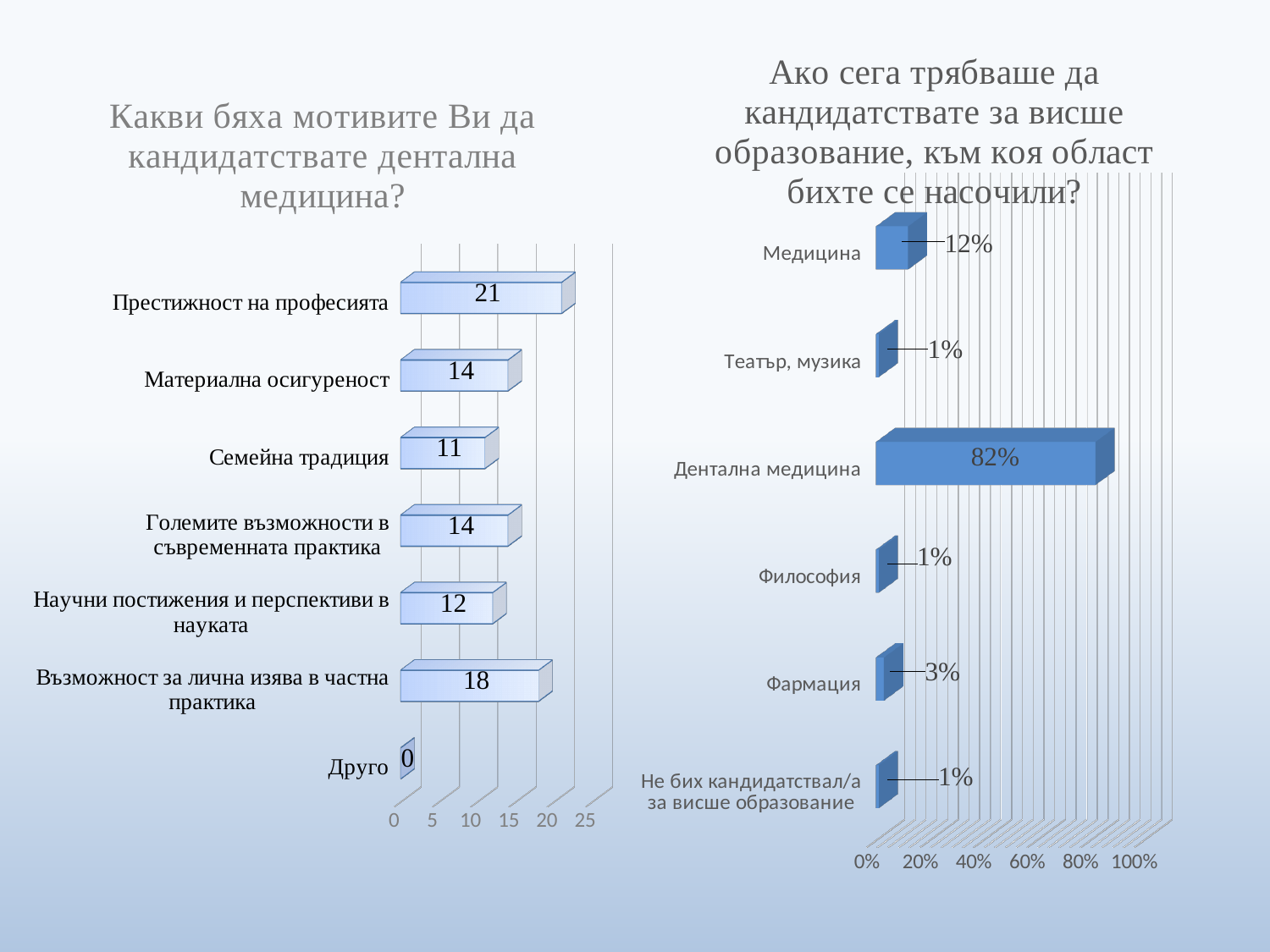
What type of chart is the right chart (Ако сега трябваше да кандидатствате за висше образование...)? Bar chart In the left chart (Какви бяха мотивите Ви да кандидатствате дентална медицина?), which category has the lowest value? Друго In the left chart (Какви бяха мотивите Ви да кандидатствате дентална медицина?), which is larger: Научни постижения и перспективи в науката or Възможност за лична изява в частна практика? Възможност за лична изява в частна практика In the right chart (Ако сега трябваше да кандидатствате за висше образование...), what is the value for Фармация? 3% In the right chart (Ако сега трябваше да кандидатствате за висше образование...), what is the value for Дентална медицина? 82% In the left chart (Какви бяха мотивите Ви да кандидатствате дентална медицина?), what is the difference between Престижност на професията and Семейна традиция? 10 In the right chart (Ако сега трябваше да кандидатствате за висше образование...), what is the difference between Дентална медицина and Медицина? 70% In the left chart (Какви бяха мотивите Ви да кандидатствате дентална медицина?), what is the value for Престижност на професията? 21 In the right chart (Ако сега трябваше да кандидатствате за висше образование...), how many categories are shown? 6 In the left chart (Какви бяха мотивите Ви да кандидатствате дентална медицина?), what is the value for Възможност за лична изява в частна практика? 18 In the left chart (Какви бяха мотивите Ви да кандидатствате дентална медицина?), how many categories are shown? 7 In the left chart (Какви бяха мотивите Ви да кандидатствате дентална медицина?), which category has the highest value? Престижност на професията